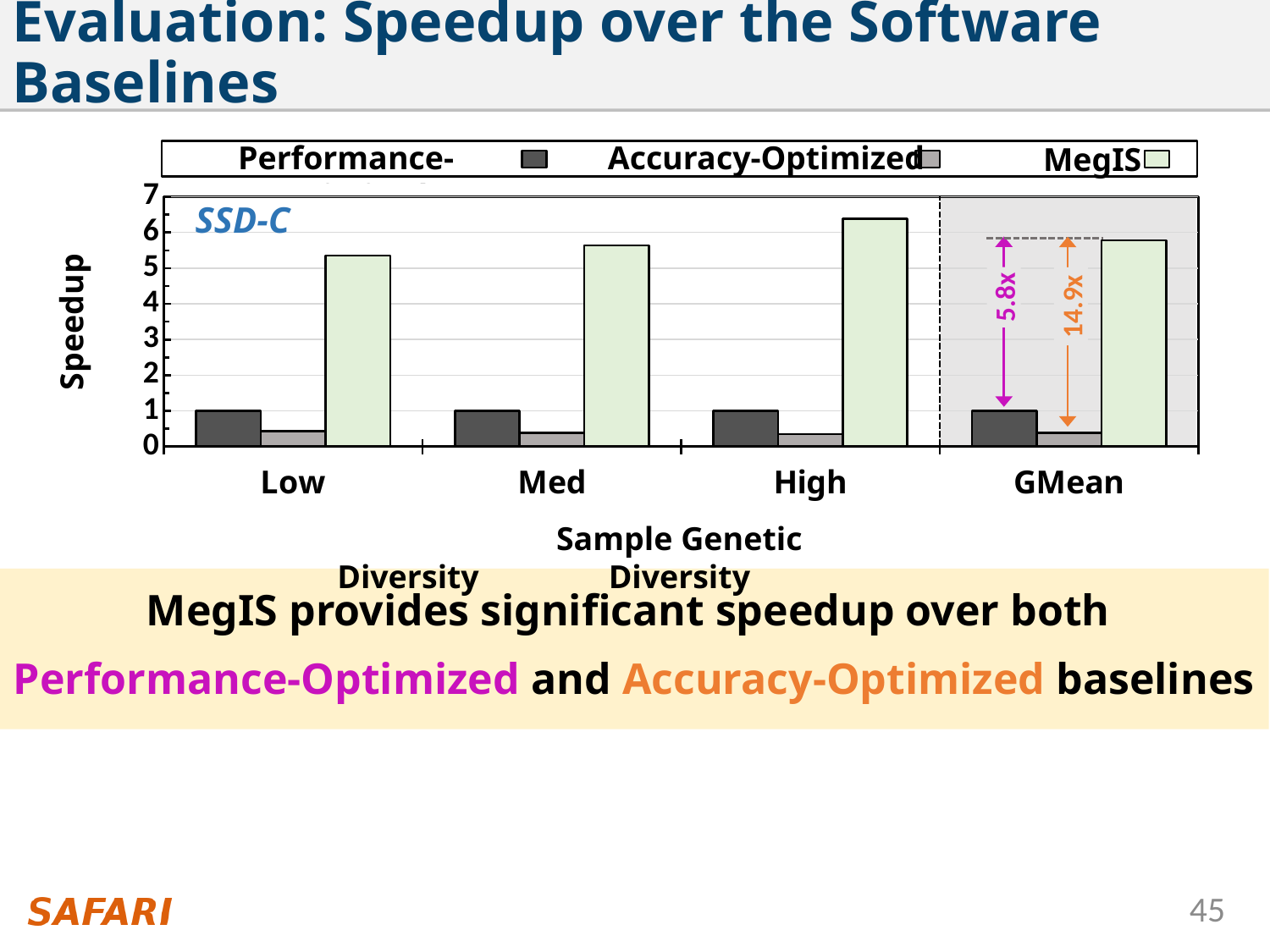
According to the annotation, what is MegIS's speedup over the Performance-Optimized baseline at GMean? 5.8x According to the annotation, what is MegIS's speedup over the Accuracy-Optimized baseline at GMean? 14.9x Is the MegIS value for High greater or less than 6? greater What is the speedup value of the Performance-Optimized bar for Med? 1 What is the label on the y axis of the chart? Speedup Is the Accuracy-Optimized value for Med greater or less than 1? less What kind of chart is shown on the slide? bar chart How many series does the legend list? 3 How many categories are shown on the x axis? 4 For Low, which is larger: the MegIS bar or the Performance-Optimized bar? MegIS Do the MegIS values rise or fall from Low to High? rise For which category is the MegIS bar the highest? High